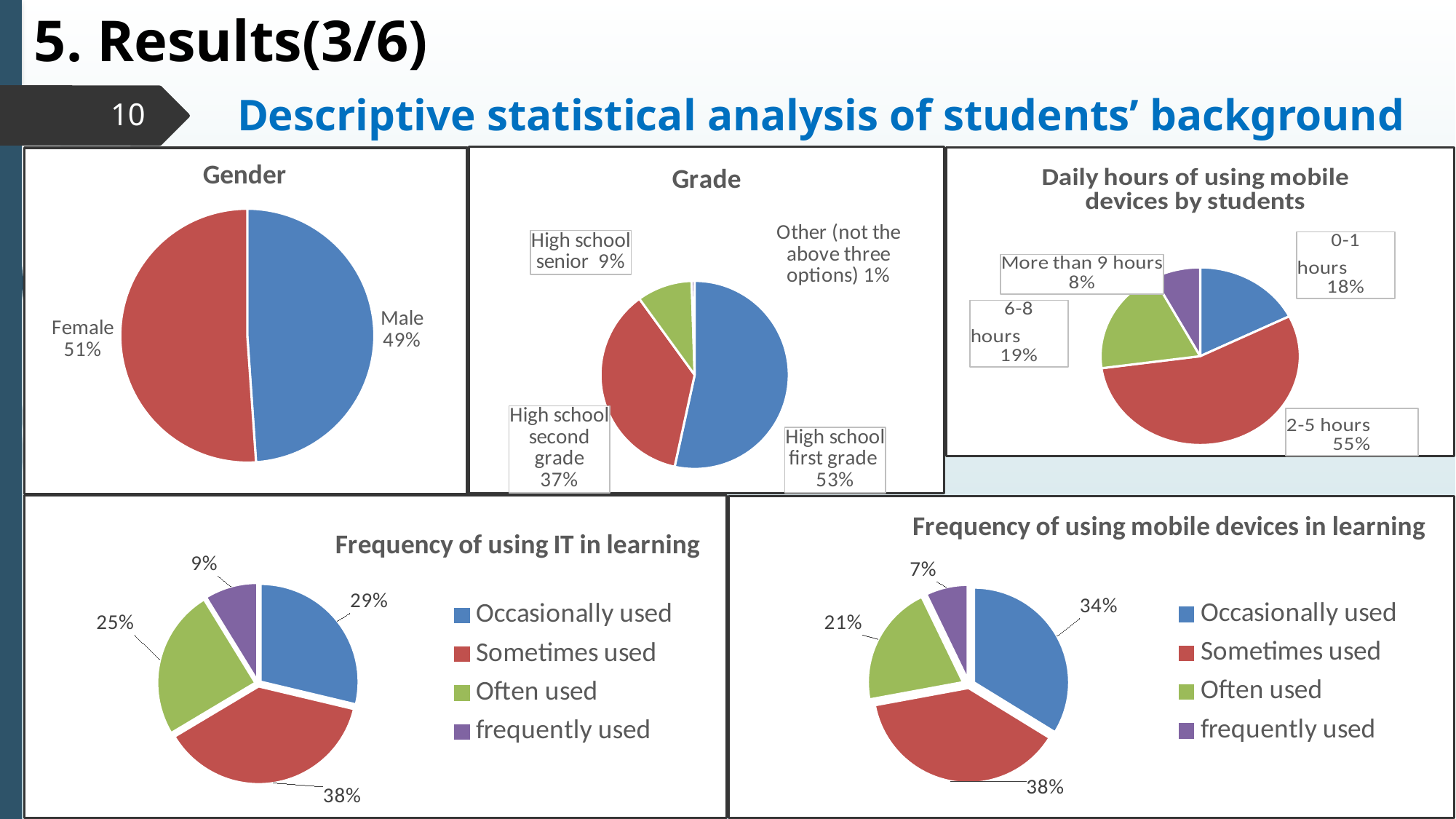
In the Grade chart, which grade has the largest share? High school first grade In the 'Daily hours of using mobile devices by students' chart, what is the share for 2-5 hours? 55% In the 'Frequency of using mobile devices in learning' chart, is the share for Occasionally used larger or smaller than the share for Often used? larger In the Grade chart, what is the difference between the High school first grade share and the High school senior share? 44% In the 'Frequency of using IT in learning' chart, which category has the largest share? Sometimes used In the Gender chart, what percentage of students are Female? 51% In the 'Frequency of using mobile devices in learning' chart, what is the share for frequently used? 7% In the 'Frequency of using IT in learning' chart, what is the share for Often used? 25% In the 'Daily hours of using mobile devices by students' chart, how many categories are shown? 4 In the Grade chart, what is the share for High school second grade? 37% In the 'Daily hours of using mobile devices by students' chart, which category has the smallest share? More than 9 hours What type of chart is the Gender chart? Pie chart